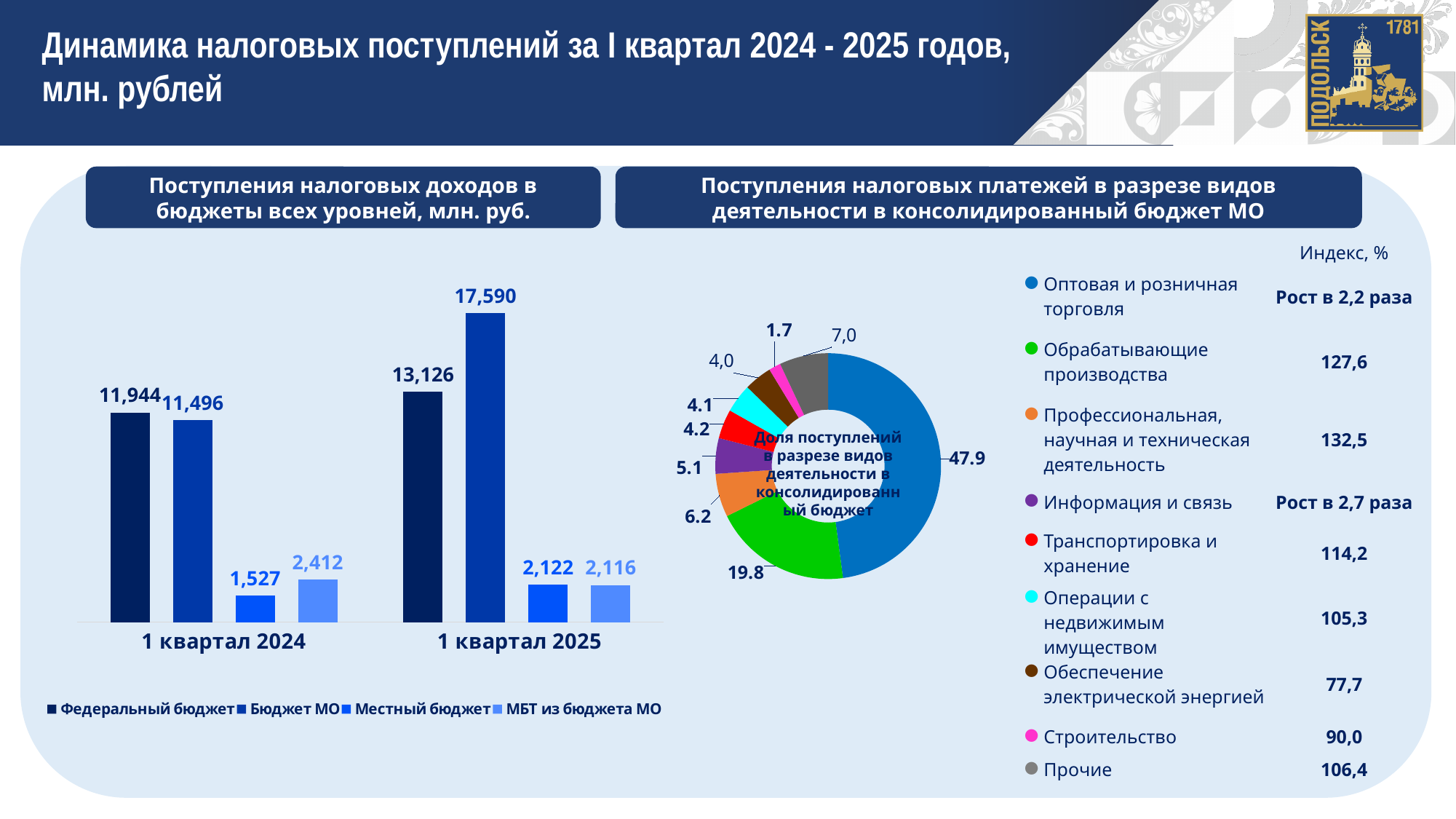
What kind of chart is the chart on the left of the slide? Bar chart How many categories does the right donut chart show? 9 In the right donut chart, which category has the smallest share? Строительство In the left bar chart, which series has the lowest value in 1 квартал 2024? Местный бюджет In the left bar chart, which series has the highest value in 1 квартал 2025? Бюджет МО How many series does the legend of the left bar chart list? 4 In the left bar chart, what is the difference between Бюджет МО in 1 квартал 2025 and in 1 квартал 2024? 6,094 In the left bar chart, what is the value for Местный бюджет in 1 квартал 2025? 2,122 In the left bar chart, what is the value for Федеральный бюджет in 1 квартал 2024? 11,944 In the left bar chart, what is the value for Бюджет МО in 1 квартал 2025? 17,590 In the left bar chart, which is larger: Федеральный бюджет in 1 квартал 2024 or Бюджет МО in 1 квартал 2024? Федеральный бюджет in 1 квартал 2024 In the right donut chart, what share is shown for Оптовая и розничная торговля? 47.9